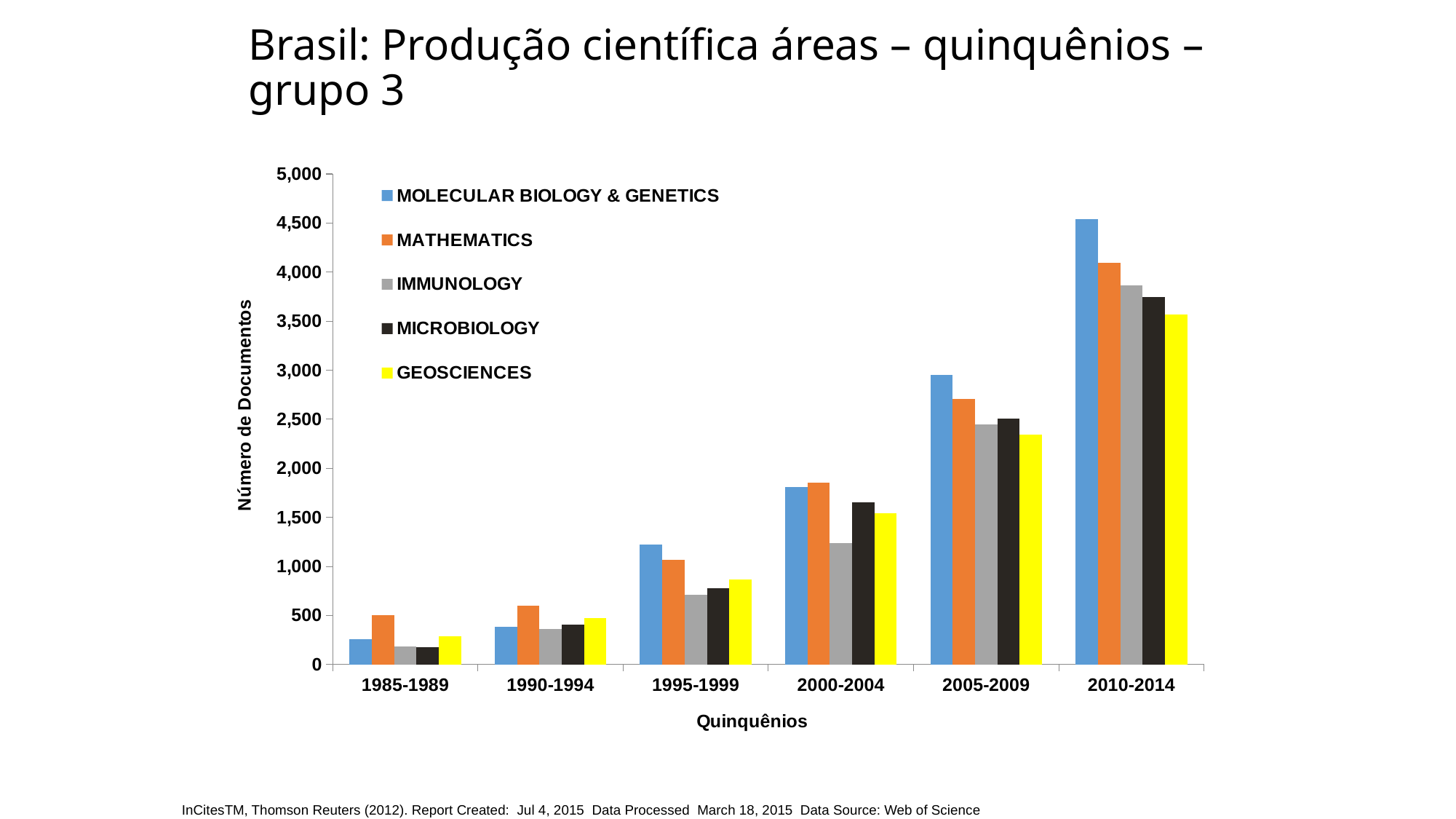
Do the values for Molecular Biology & Genetics rise or fall from 1985-1989 to 2010-2014? rise What is the title of the y axis? Número de Documentos Which area has the highest number of documents in 1985-1989? Mathematics Which area has the lowest number of documents in 2010-2014? Geosciences Is the value for Mathematics in 2005-2009 greater or less than 2,500? greater How many series does the legend list? 5 Which area has the highest number of documents in 2010-2014? Molecular Biology & Genetics How many quinquênios (periods) are shown on the x axis? 6 In 2000-2004, which is larger: Immunology or Microbiology? Microbiology Is the value for Geosciences in 2005-2009 greater or less than 2,500? less Is the value for Molecular Biology & Genetics in 2010-2014 greater or less than 4,000? greater What kind of chart is shown on the slide? Bar chart